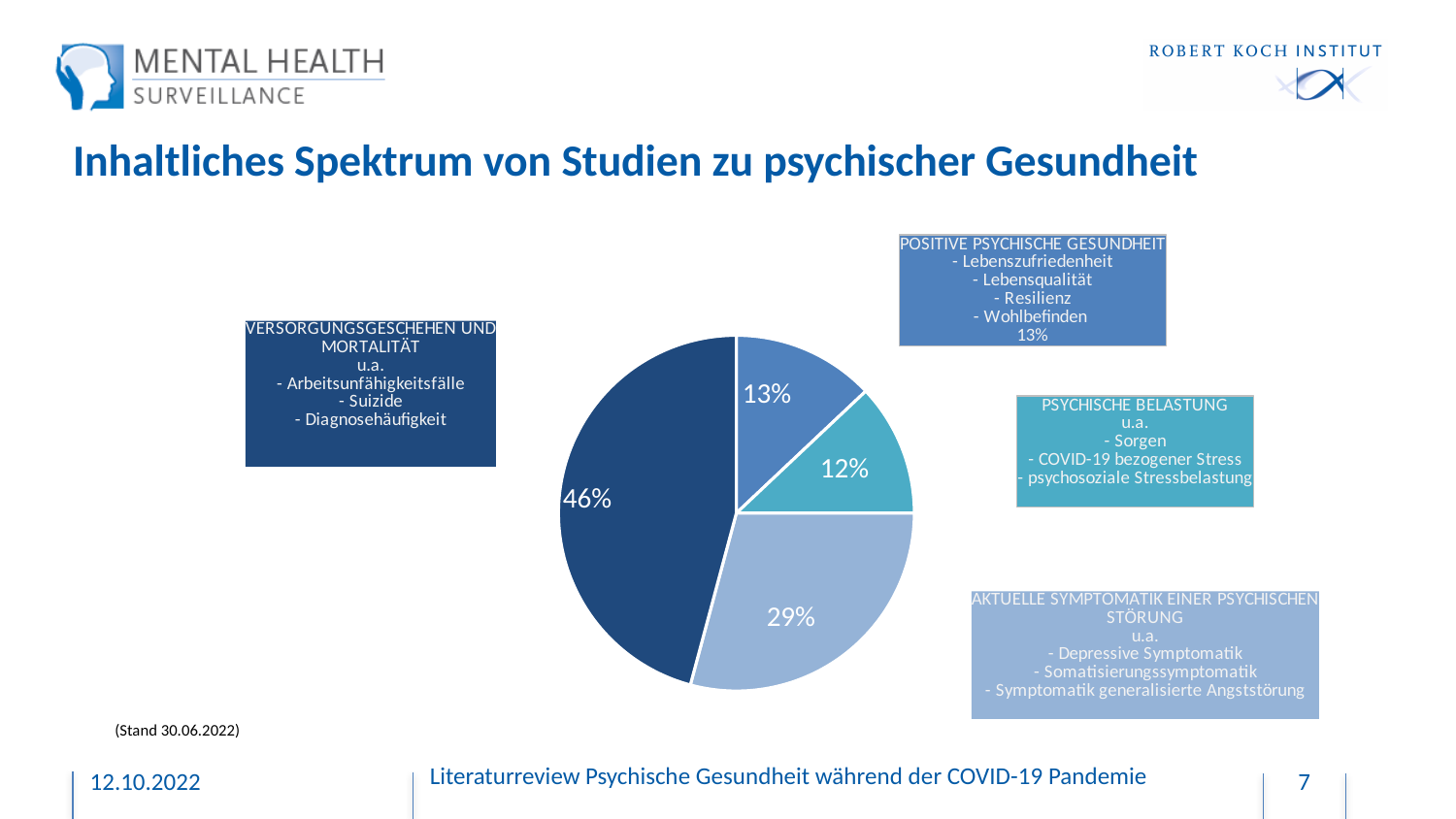
What is the title of the slide containing the pie chart? Inhaltliches Spektrum von Studien zu psychischer Gesundheit What share of the pie does the slice for AKTUELLE SYMPTOMATIK EINER PSYCHISCHEN STÖRUNG represent? 29% What share of the pie does the slice for POSITIVE PSYCHISCHE GESUNDHEIT represent? 13% Which category has the smallest slice of the pie? PSYCHISCHE BELASTUNG What kind of chart is shown on the slide? pie chart Which category has the largest slice of the pie? VERSORGUNGSGESCHEHEN UND MORTALITÄT What is the difference in percentage points between the VERSORGUNGSGESCHEHEN UND MORTALITÄT slice and the AKTUELLE SYMPTOMATIK EINER PSYCHISCHEN STÖRUNG slice? 17 What share of the pie does the slice for VERSORGUNGSGESCHEHEN UND MORTALITÄT represent? 46% What is the combined share of the PSYCHISCHE BELASTUNG and POSITIVE PSYCHISCHE GESUNDHEIT slices? 25% Which slice is larger: POSITIVE PSYCHISCHE GESUNDHEIT or PSYCHISCHE BELASTUNG? POSITIVE PSYCHISCHE GESUNDHEIT How many slices does the pie chart have? 4